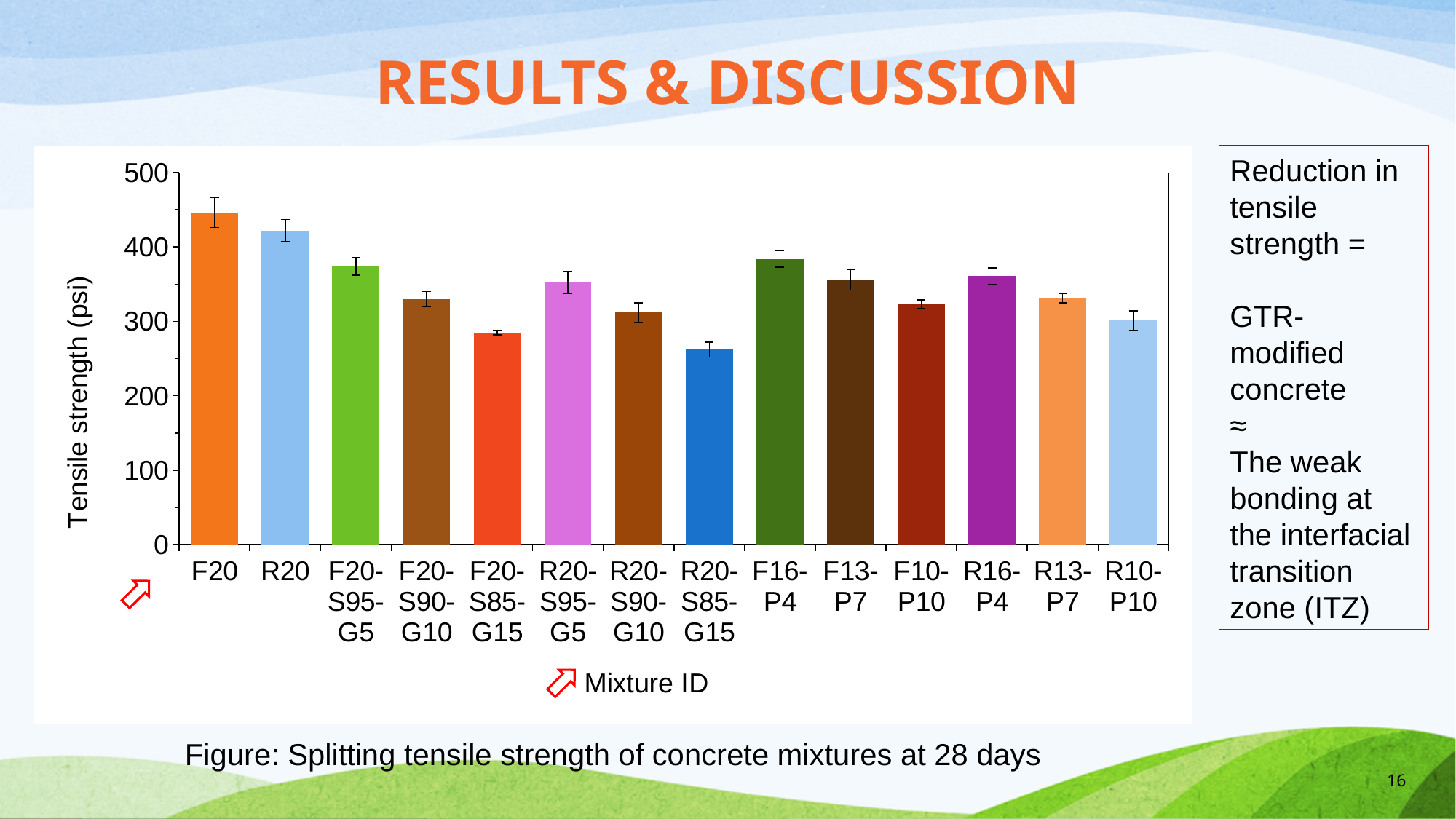
Which has the higher tensile strength, F20-S95-G5 or R20-S95-G5? F20-S95-G5 What kind of chart is shown on the slide? bar chart Is the tensile strength for F20-S90-G10 greater or less than 300 psi? greater Which mixture ID has the lowest tensile strength in the chart? R20-S85-G15 Is the tensile strength for F16-P4 greater or less than 400 psi? less Which mixture ID has the highest tensile strength in the chart? F20 Is the tensile strength for R20-S85-G15 greater or less than 300 psi? less Which has the higher tensile strength, F20 or R20? F20 How many mixture IDs are plotted on the x axis of the chart? 14 What is the label of the y axis of the chart? Tensile strength (psi)